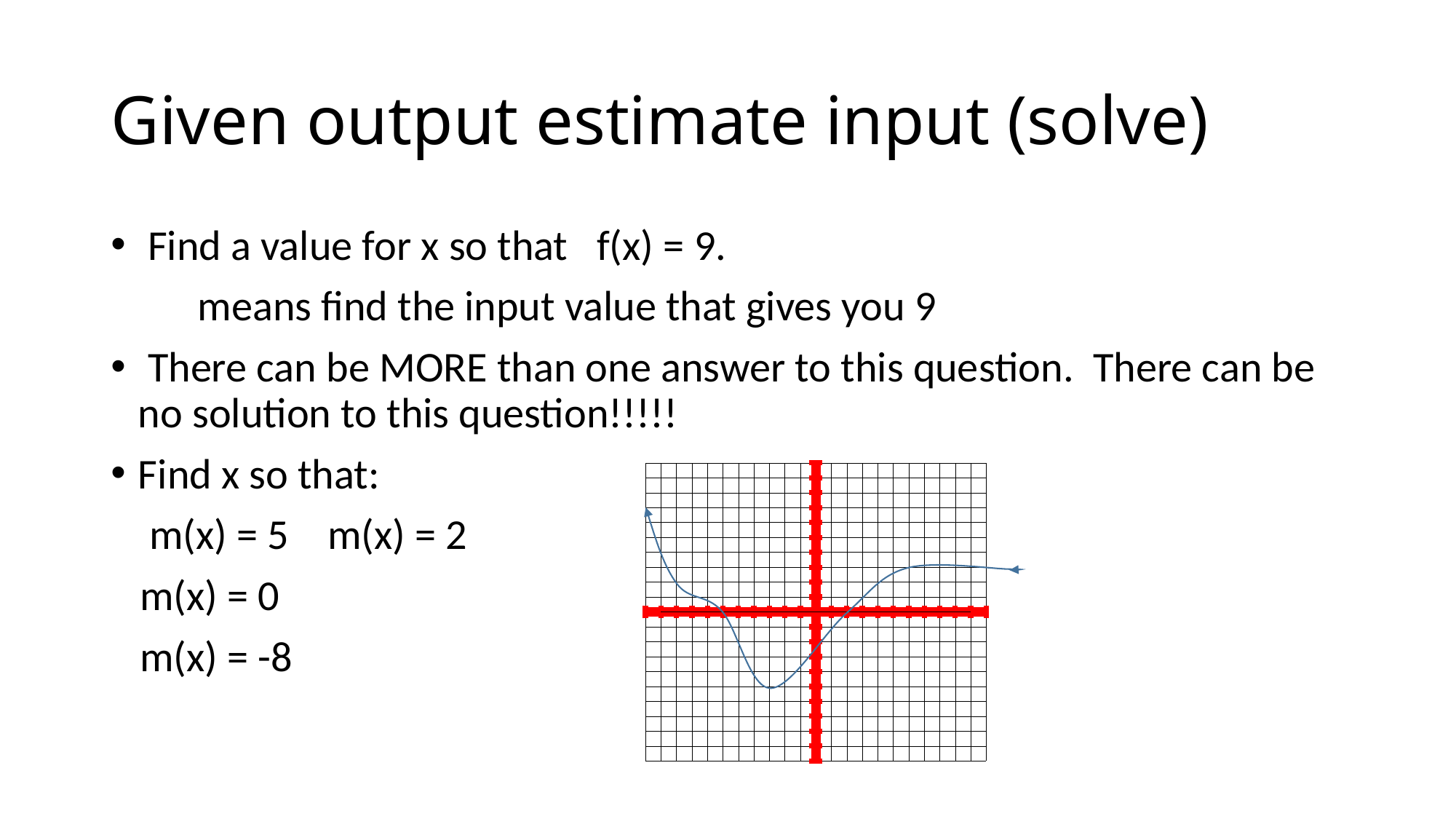
After reaching its lowest point, does the curve rise or fall as x increases? rise At the far right of the grid, is the curve above or below the horizontal axis? above What kind of chart is shown on the slide? a line graph (a curve on a grid) Does the plotted curve rise or fall as it moves from the left edge toward its lowest point? fall Is the lowest point of the curve above or below the horizontal axis? below What colour is the plotted curve? blue What colour are the axes drawn on the grid? red How many curves are plotted on the grid? 1 Is the lowest point of the curve to the left or to the right of the vertical axis? left How many times does the curve cross the horizontal axis? 2